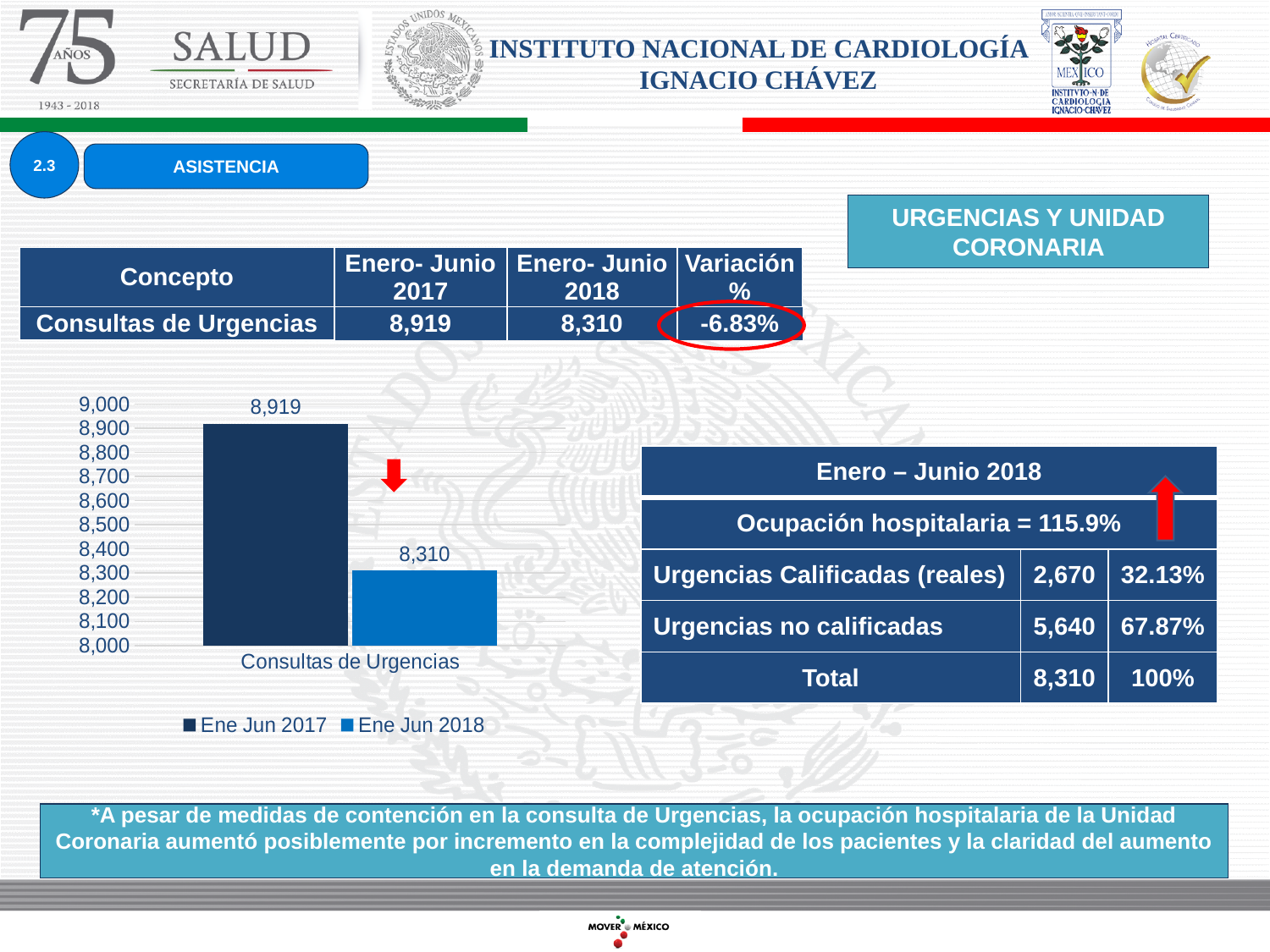
What is the value of the Ene Jun 2017 bar for Consultas de Urgencias? 8,919 What is the difference between the Ene Jun 2017 and Ene Jun 2018 values for Consultas de Urgencias? 609 Is the value of the Ene Jun 2018 bar greater or less than 8,500? less What is the lowest value shown on the y axis of the chart? 8,000 Is the value of the Ene Jun 2017 bar greater or less than 8,800? greater What is the category label shown on the x axis of the chart? Consultas de Urgencias What is the value of the Ene Jun 2018 bar for Consultas de Urgencias? 8,310 What kind of chart is shown on the slide? Bar chart How many series does the chart legend list? 2 Which series has the higher value for Consultas de Urgencias, Ene Jun 2017 or Ene Jun 2018? Ene Jun 2017 How many categories are shown on the x axis of the chart? 1 What are the two legend entries of the chart? Ene Jun 2017 and Ene Jun 2018